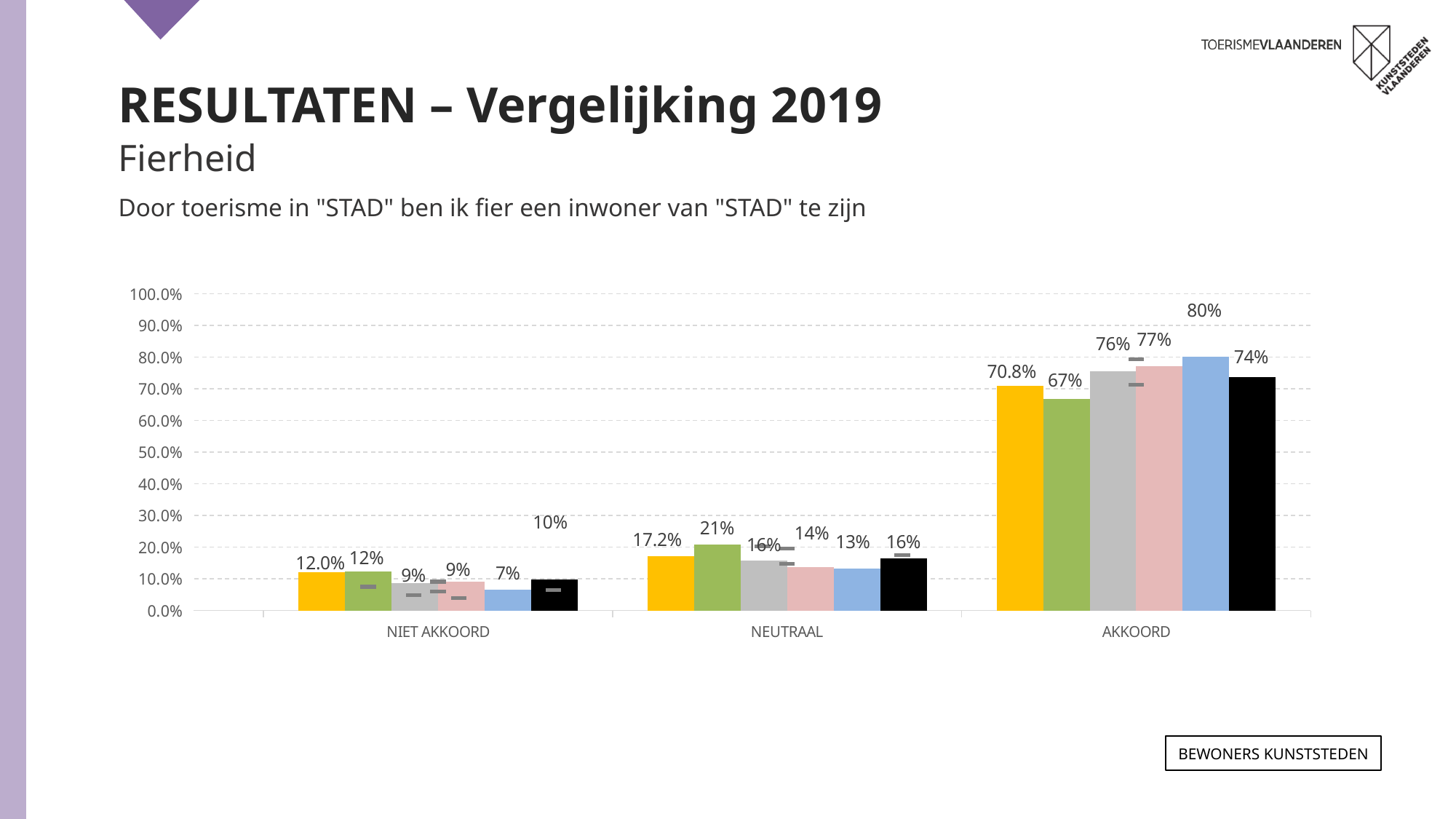
What kind of chart is shown on the slide? bar chart What is the value of the green bar for NEUTRAAL? 21% How many categories are shown on the x axis? 3 Which bar is the highest in the AKKOORD group? the blue bar (80%) What is the value of the yellow bar for AKKOORD? 70.8% What is the difference between the blue bar (80%) and the green bar (67%) in the AKKOORD group? 13 percentage points What is the value of the blue bar for AKKOORD? 80% What is the value of the black bar for NIET AKKOORD? 10% In the NEUTRAAL group, which is larger: the green bar or the blue bar? the green bar Which bar is the lowest in the NIET AKKOORD group? the blue bar (7%) Is the value of the pink bar for AKKOORD greater or less than 70%? greater What is the label of the rightmost category on the x axis? AKKOORD